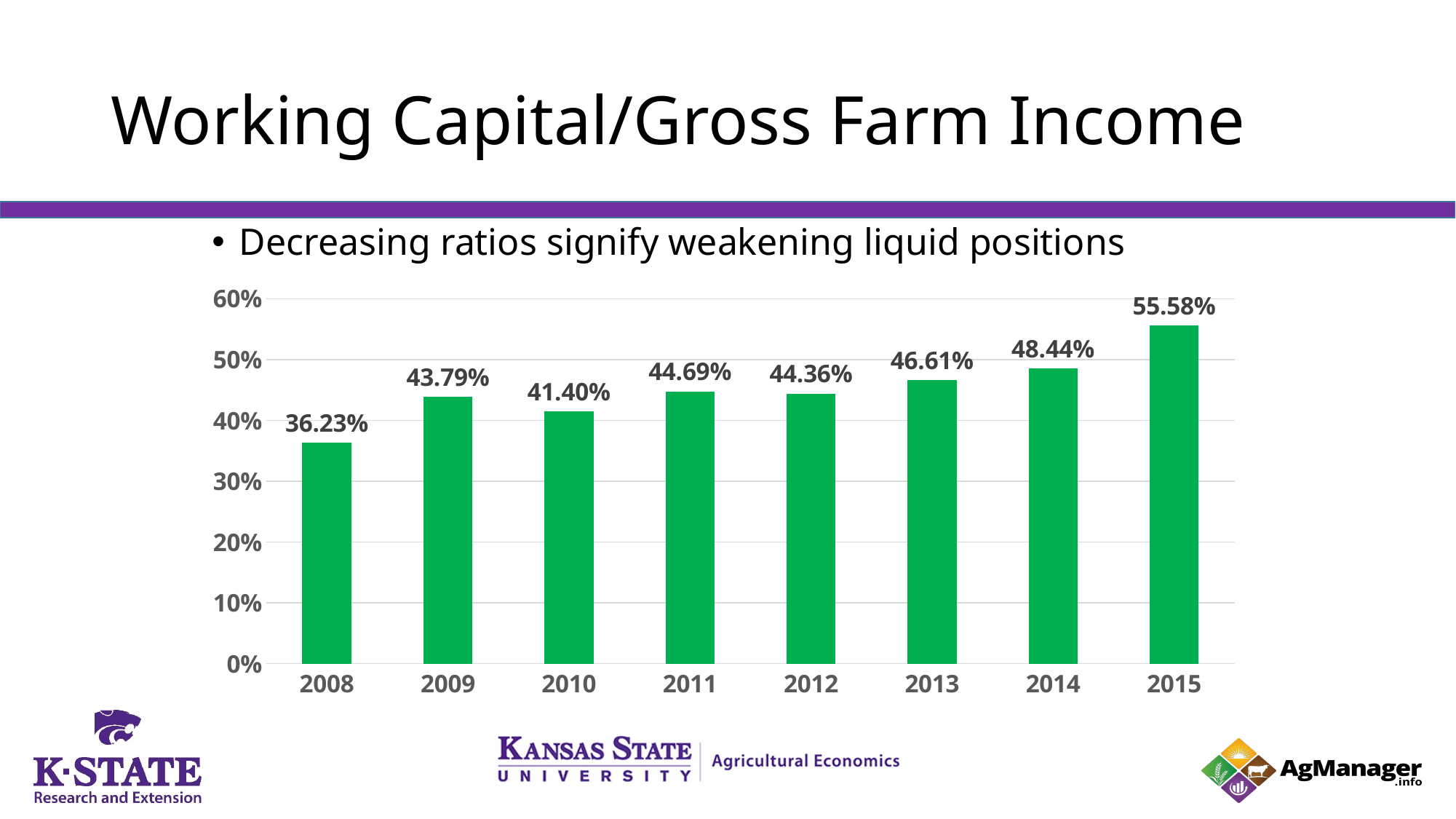
What is the difference between the values for 2009 and 2008? 7.56% What kind of chart is shown on the slide? bar chart What is the value for 2008? 36.23% How many years are shown on the x axis? 8 What is the value for 2012? 44.36% Is the value for 2014 greater or less than 50%? less Which year has the lowest value? 2008 Which is larger, the value for 2010 or the value for 2013? 2013 What is the value for 2015? 55.58% What colour are the bars in the chart? green Which year has the highest value? 2015 What is the difference between the values for 2015 and 2014? 7.14%